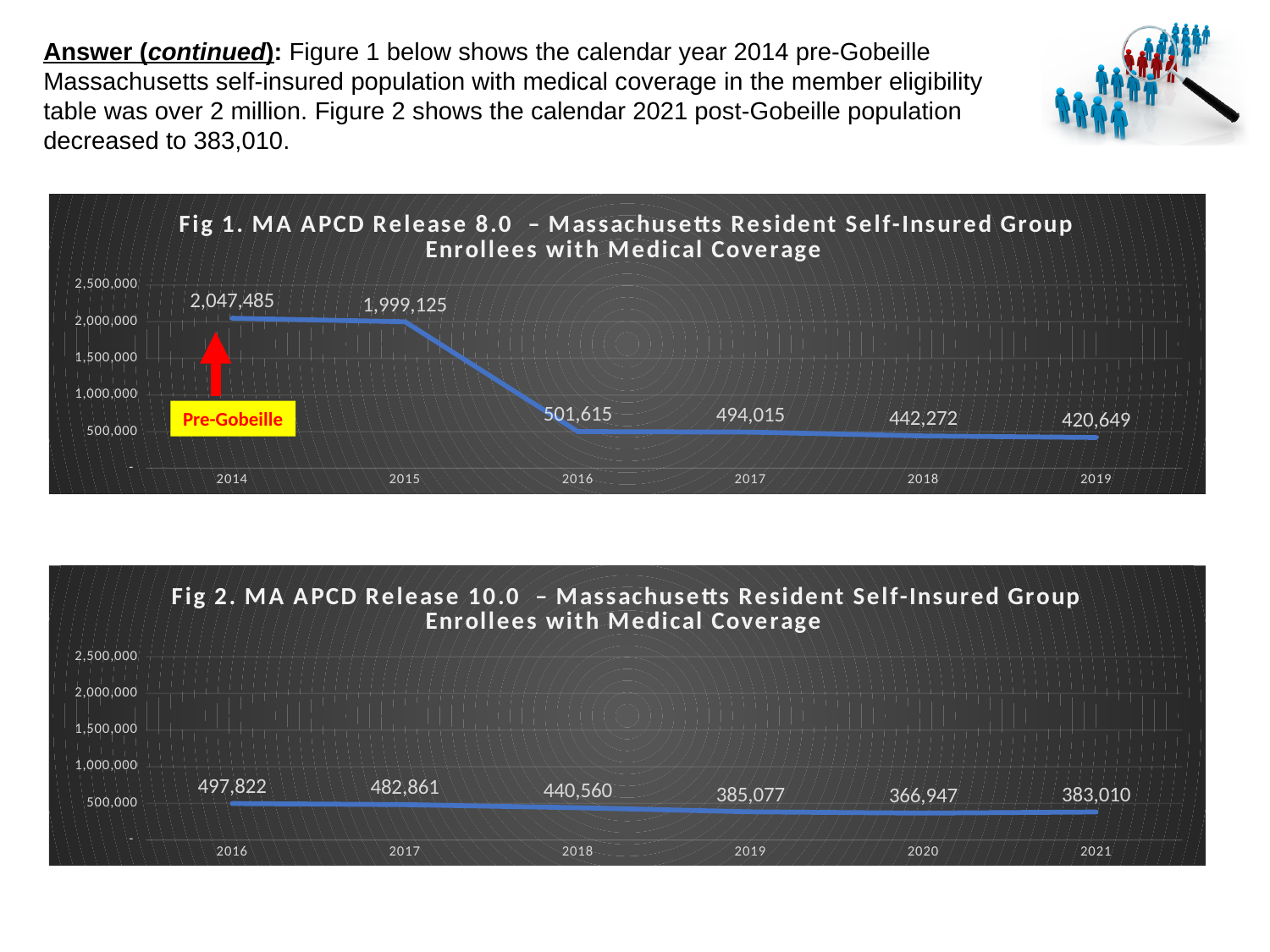
What type of chart is Fig 2? Line chart In Fig 1, what is the difference between the 2014 value and the 2015 value? 48,360 In Fig 1, which year has the highest value? 2014 In Fig 1, do the values generally rise or fall from 2014 to 2019? Fall In Fig 1, what is the value for 2014? 2,047,485 In Fig 2, what is the value for 2021? 383,010 In Fig 1, how many years are plotted on the x axis? 6 In Fig 2, what is the value for 2018? 440,560 In Fig 2, which is larger, the value for 2016 or the value for 2017? 2016 In Fig 1, what does the yellow label next to the red arrow say? Pre-Gobeille In Fig 2, which year has the lowest value? 2020 In Fig 1, what is the value for 2017? 494,015